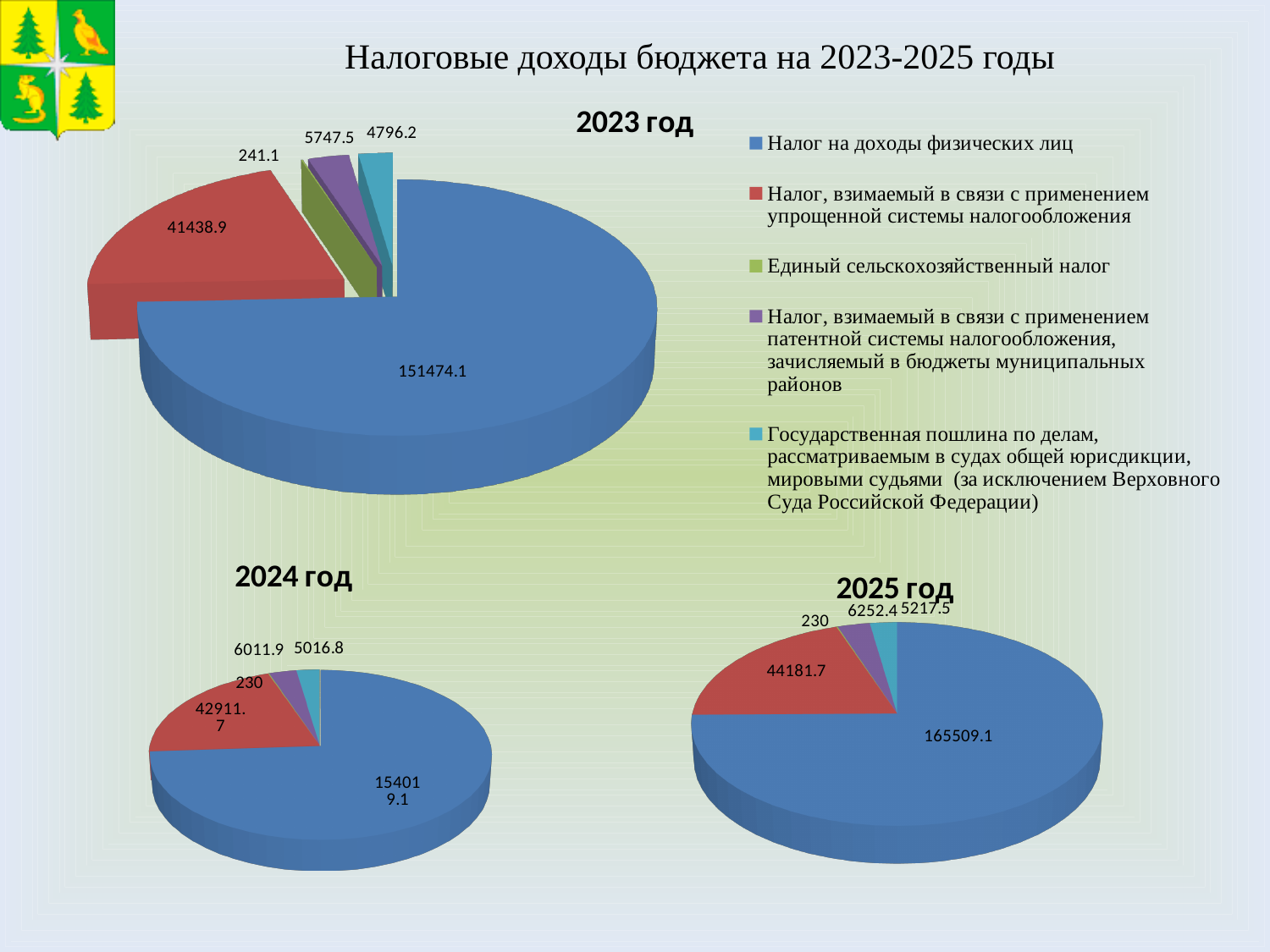
In the 2023 год chart, what is the value for Налог на доходы физических лиц? 151474.1 In the 2023 год chart, what is the value for Налог, взимаемый в связи с применением упрощенной системы налогообложения? 41438.9 In the 2023 год chart, which category has the largest slice? Налог на доходы физических лиц In the 2025 год chart, which category has the smallest value? Единый сельскохозяйственный налог How many categories does the legend list? 5 In the 2024 год chart, which is larger: the value for the patent system tax (purple) or the state duty (cyan)? Patent system tax (6011.9) What kind of charts are shown on the slide? Pie charts In the 2025 год chart, what is the value for Налог на доходы физических лиц? 165509.1 In the 2025 год chart, what is the value for Налог, взимаемый в связи с применением упрощенной системы налогообложения? 44181.7 How many pie charts are on the slide? 3 In the 2023 год chart, what is the value for Единый сельскохозяйственный налог? 241.1 In the 2023 год chart, what is the difference between Налог на доходы физических лиц and Налог, взимаемый в связи с применением упрощенной системы налогообложения? 110035.2